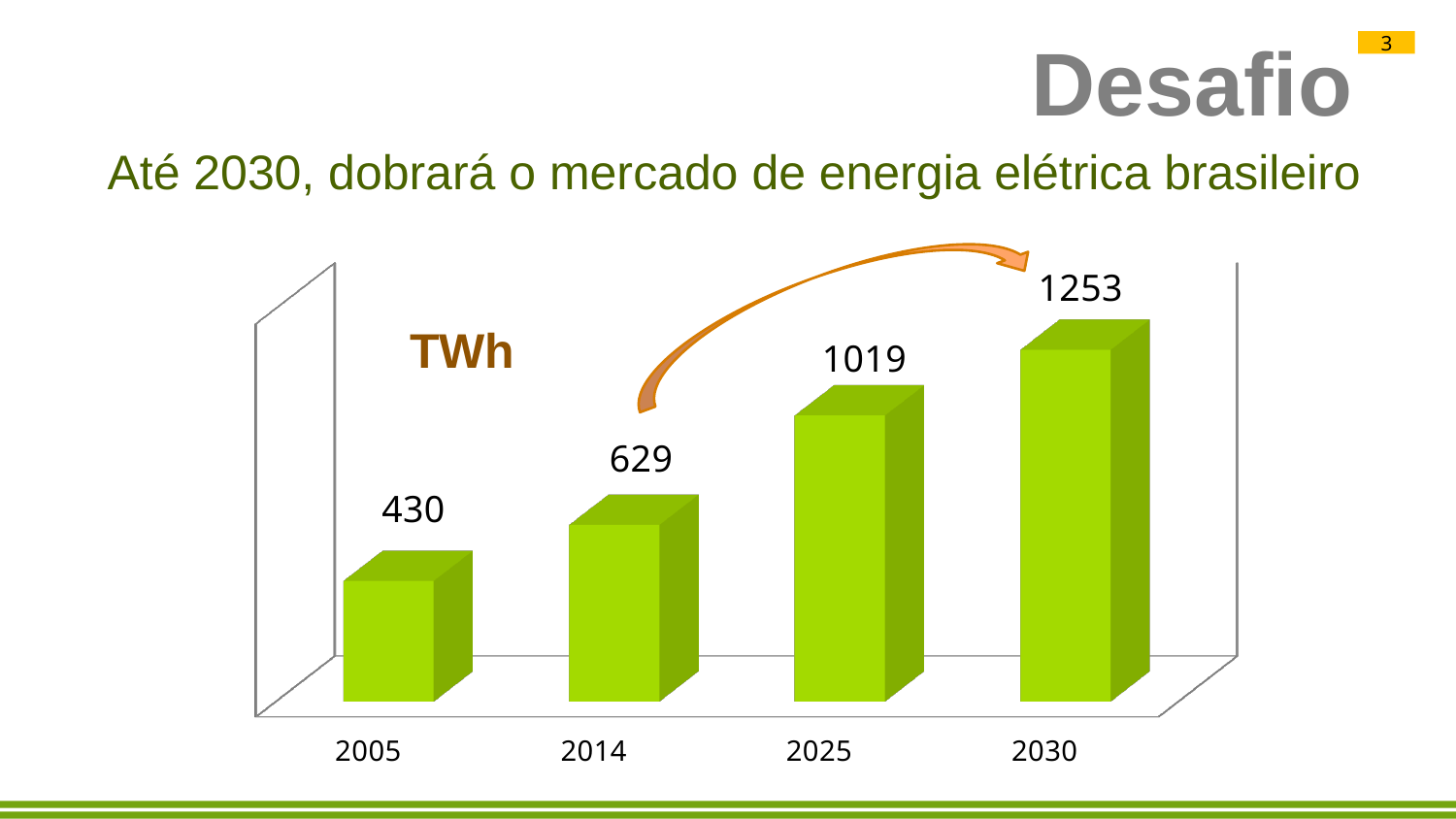
Which year has the highest value? 2030 Which year has the lowest value? 2005 What kind of chart is shown? bar chart What is the value for 2014? 629 What is the value for 2030? 1253 Which is larger, the value for 2014 or the value for 2025? 2025 What is the value for 2005? 430 What is the difference between the values for 2030 and 2014? 624 Do the values rise or fall from 2005 to 2030? rise What is the value for 2025? 1019 How many years are shown on the x axis? 4 What is the difference between the values for 2025 and 2005? 589